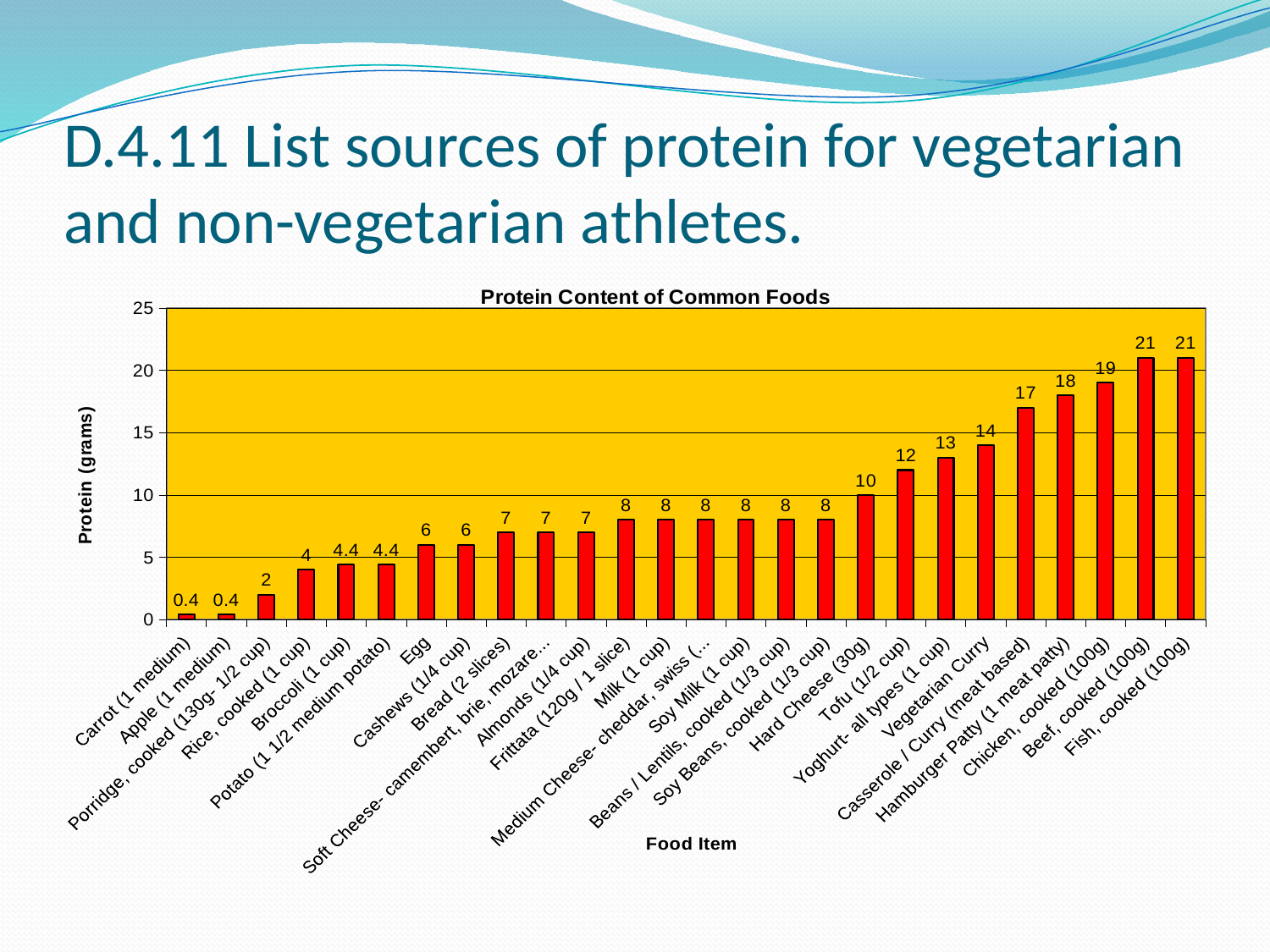
What is the difference in protein between Chicken, cooked (100g) and Tofu (1/2 cup)? 7 What kind of chart is shown on the slide? bar chart What is the lowest protein value shown on the chart? 0.4 What is the title of the chart? Protein Content of Common Foods Which has more protein, Vegetarian Curry or Casserole / Curry (meat based)? Casserole / Curry (meat based) What is the protein content shown for Egg? 6 Is the value for Yoghurt- all types (1 cup) greater or less than 10? greater What is the protein value for Hard Cheese (30g)? 10 What value is shown for Chicken, cooked (100g)? 19 How many grams of protein are shown for Tofu (1/2 cup)? 12 How many food items are plotted on the chart? 26 What is the highest protein value shown on the chart? 21